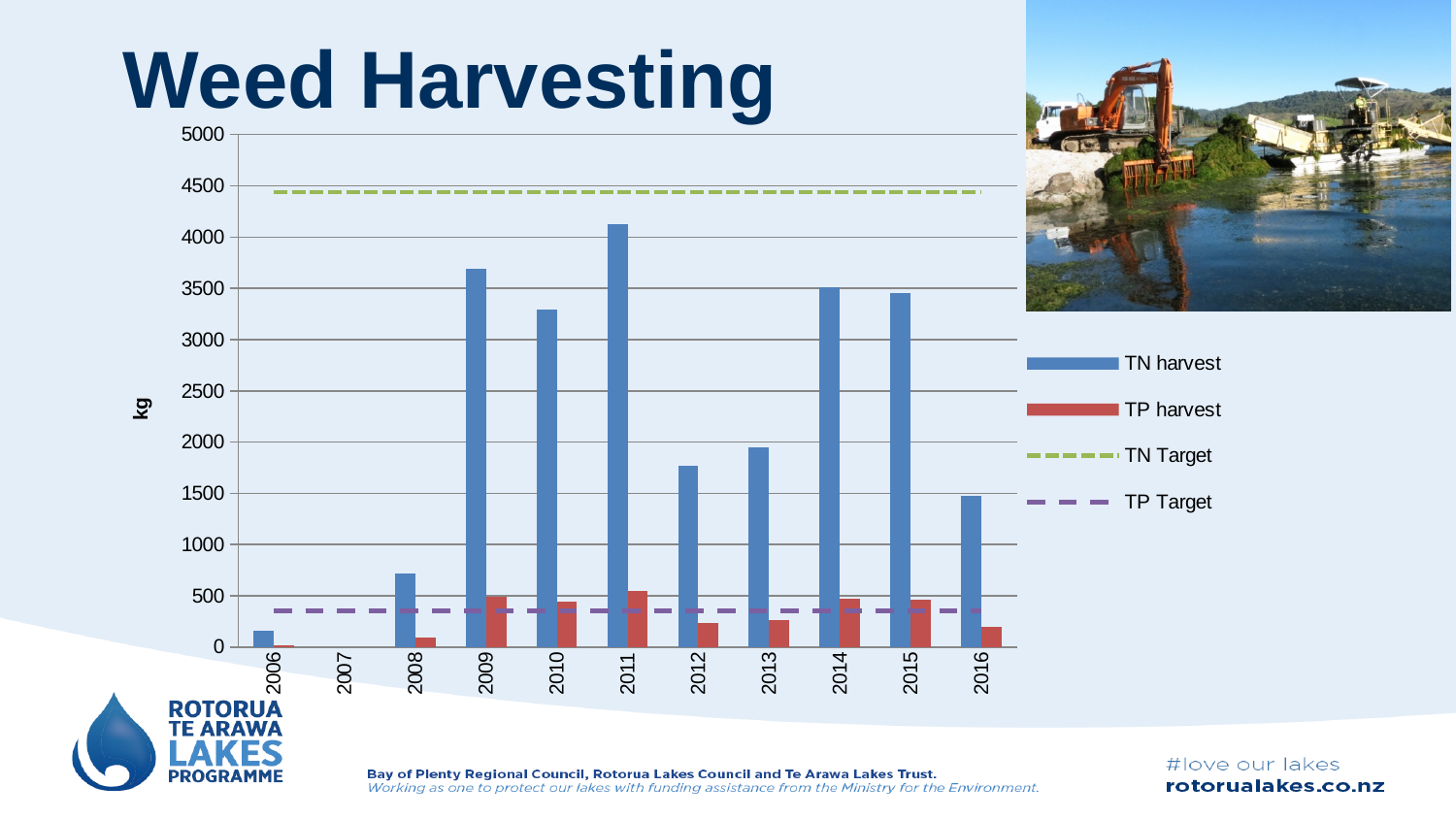
Which year has the highest TN harvest? 2011 How many series does the legend list? 4 What kind of chart is shown on the slide? combination bar and line chart Is the TN harvest for 2012 greater or less than 1500? greater Is the TN harvest for 2009 greater or less than 3500? greater Is the TP harvest for 2012 greater or less than 500? less What is the label on the y axis? kg Which is larger, the TN harvest for 2009 or for 2010? 2009 Which is larger, the TP harvest for 2011 or for 2012? 2011 How many years are shown on the x axis? 11